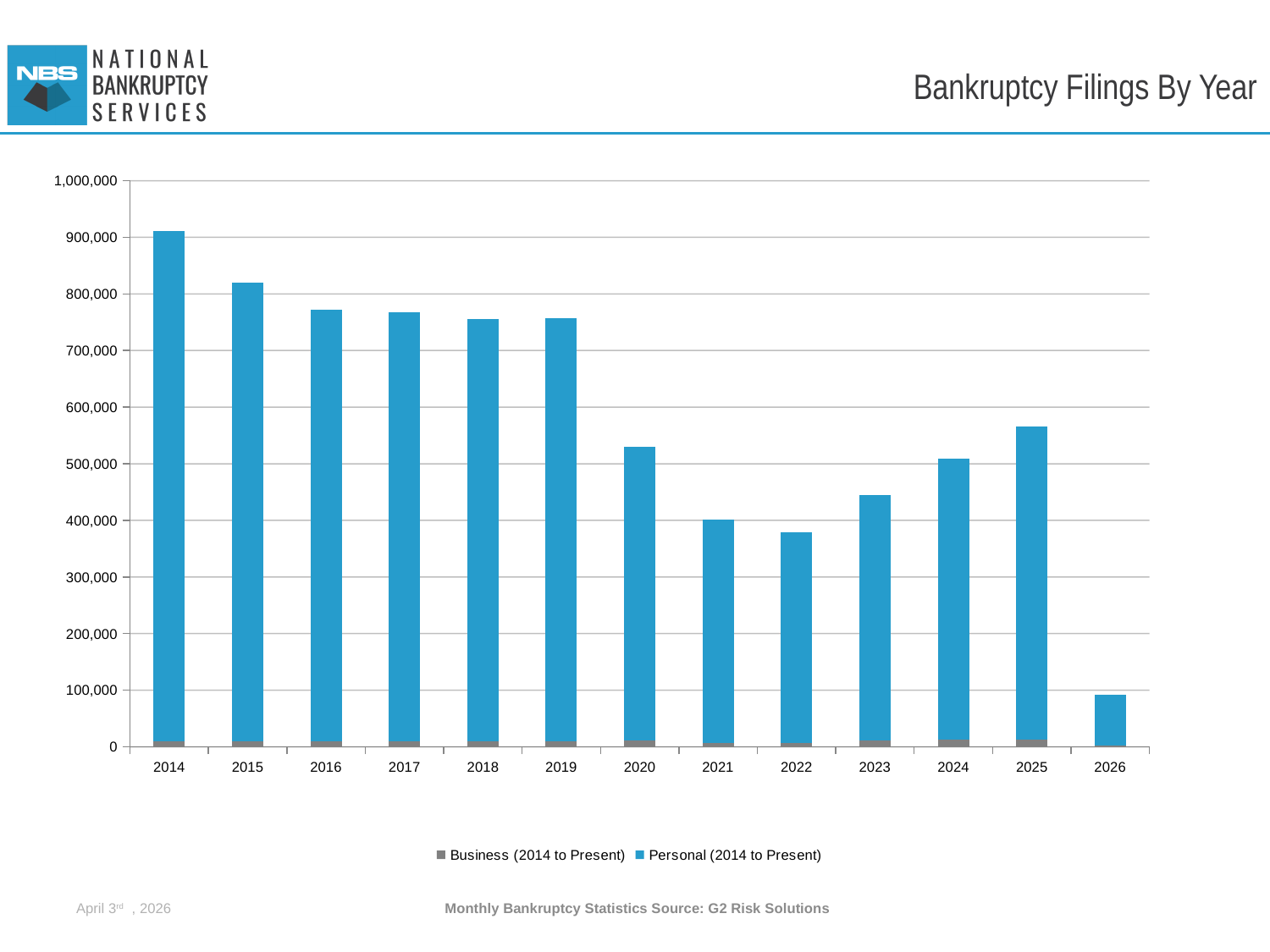
How many series does the legend list? 2 Which year has the highest total bankruptcy filings? 2014 How many years are shown on the x axis of the chart? 13 Is the total for 2026 greater or less than 100,000? less What is the title of the chart? Bankruptcy Filings By Year Is the total for 2022 greater or less than 400,000? less Which year has the larger total, 2023 or 2024? 2024 Is the total for 2020 greater or less than 500,000? greater Which year has the lowest total bankruptcy filings? 2026 What kind of chart is shown on the slide? Stacked bar chart Do total filings rise or fall from 2014 to 2019? fall